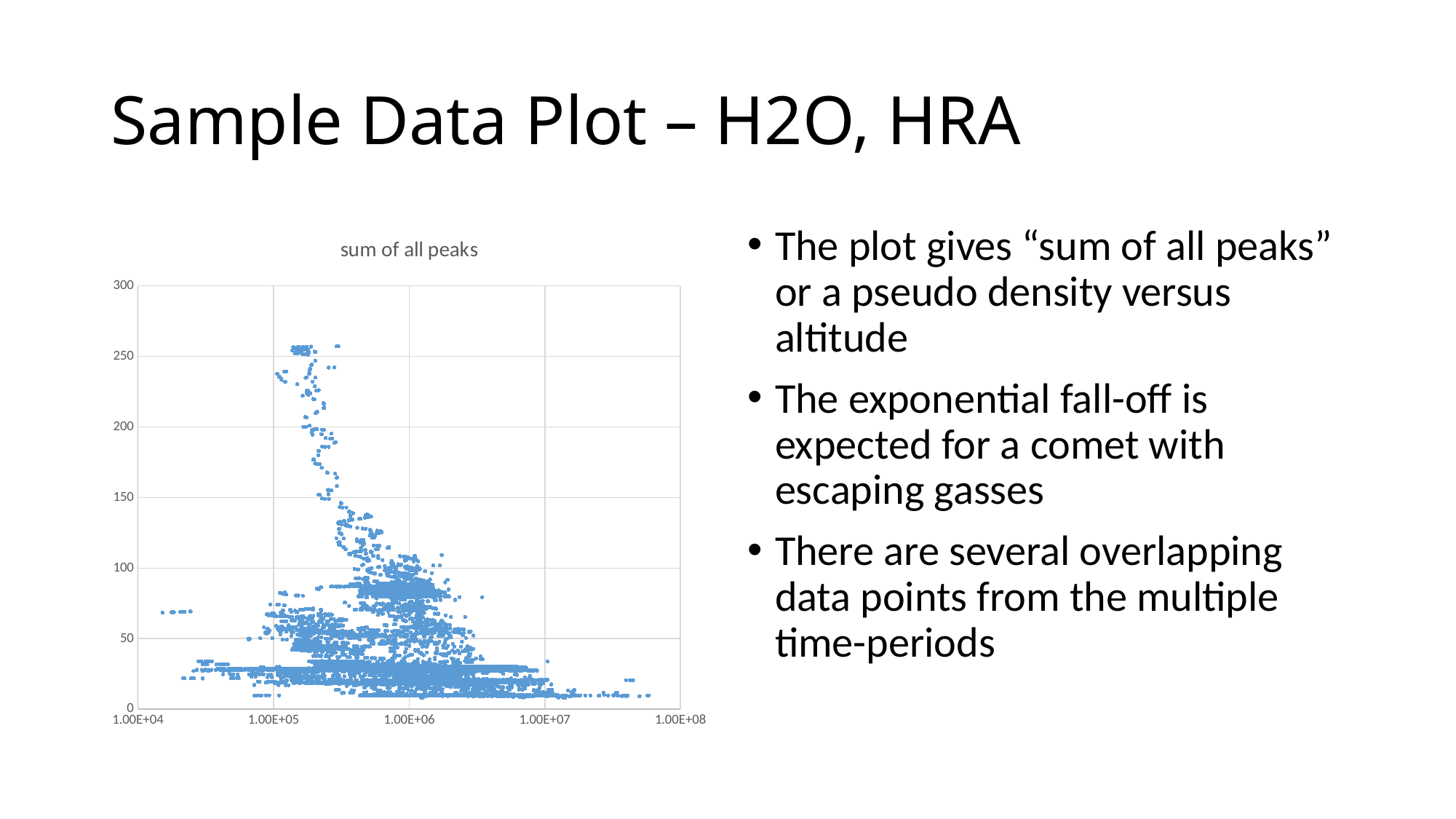
Do the plotted values generally rise or fall as the x-axis value increases? fall What is the smallest value labelled on the x axis of the chart? 1.00E+04 What kind of chart is shown on the slide? scatter plot Are the points plotted near 1.00E+07 on the x axis greater or less than 50? less What colour are the data points in the chart? blue Is the highest plotted value in the chart greater or less than 300? less What is the highest value labelled on the y axis of the chart? 300 What is the title of the chart? sum of all peaks Is the highest plotted value in the chart greater or less than 200? greater What is the largest value labelled on the x axis of the chart? 1.00E+08 How many tick labels are shown on the x axis of the chart? 5